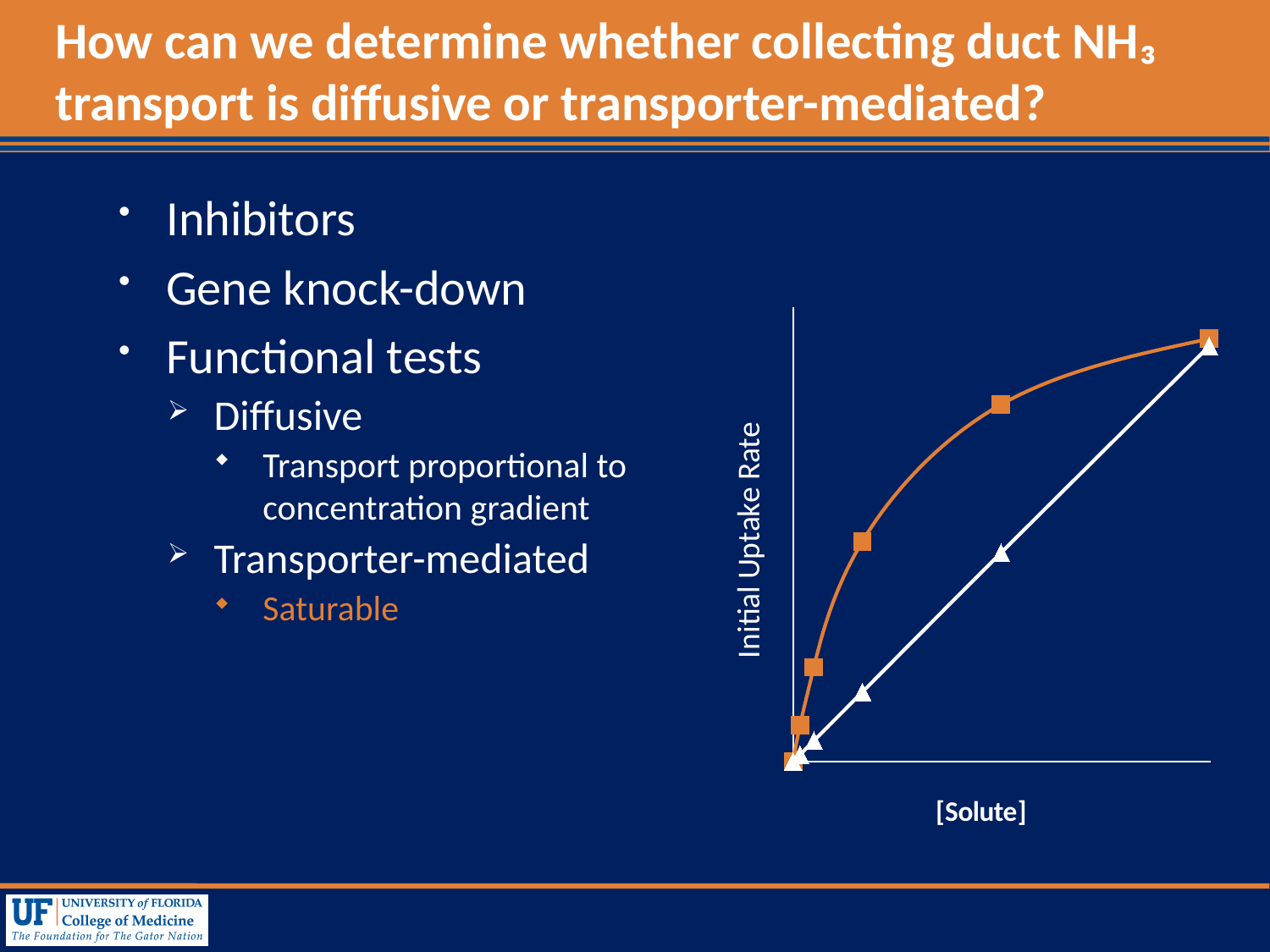
What is the label of the y axis of the chart? Initial Uptake Rate What kind of chart is shown on the slide? line chart How many data series are plotted on the chart? 2 What is the label of the x axis of the chart? [Solute] Which series on the chart follows a straight line? white triangles Which series on the chart levels off (saturates) at high solute concentrations? orange squares Does the initial uptake rate for the orange square series rise or fall as [Solute] increases? rise Does the initial uptake rate for the white triangle series rise or fall as [Solute] increases? rise At intermediate solute concentrations, which series shows the higher initial uptake rate, the orange squares or the white triangles? orange squares